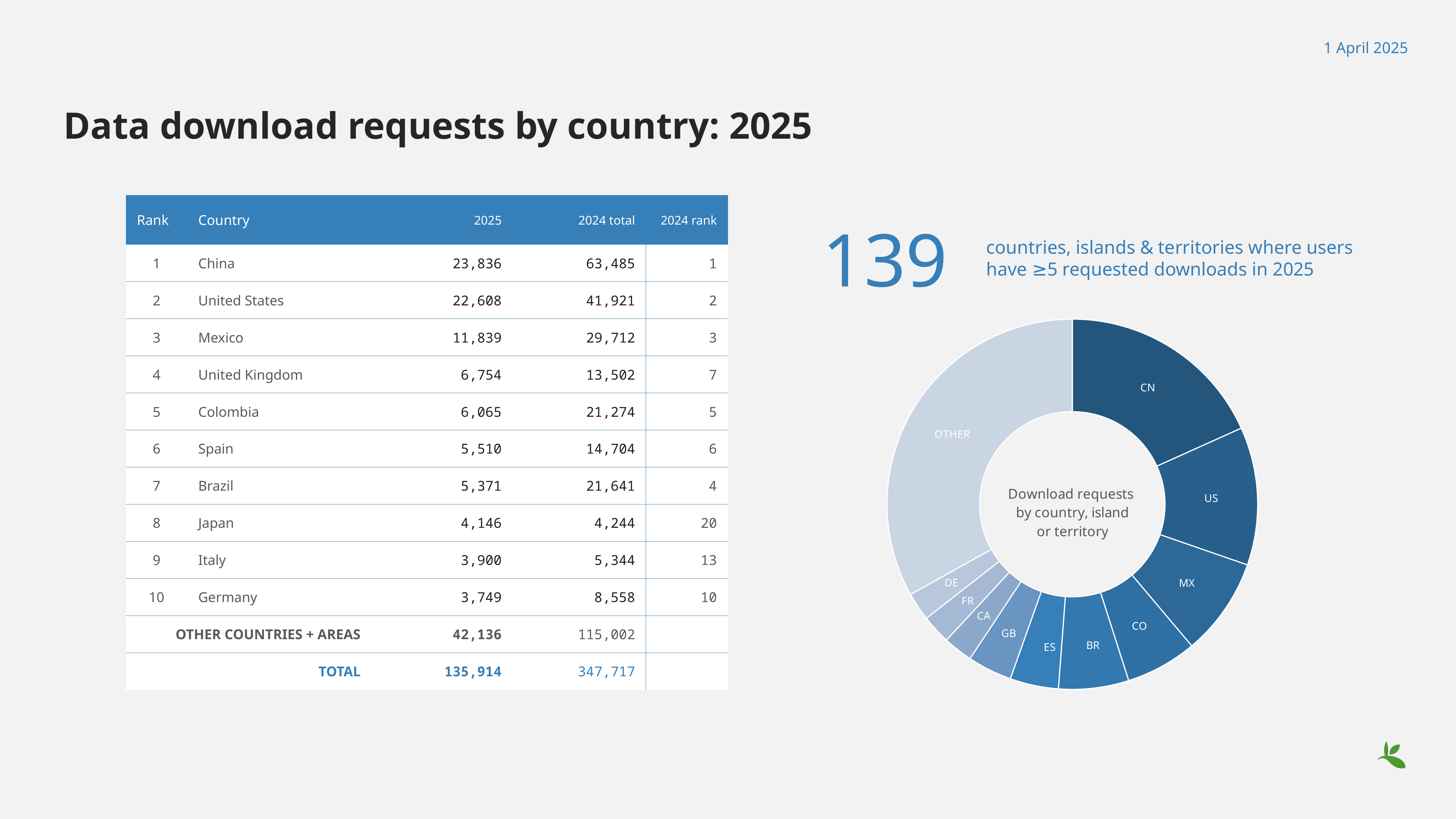
Which slice of the donut chart is the largest? OTHER According to the slide, how many download requests does the CN slice of the donut chart represent in 2025? 23,836 According to the slide, how many download requests does the OTHER slice of the donut chart represent in 2025? 42,136 In the donut chart, which slice is larger, US or GB? US Using the 2025 values on the slide, what is the difference between the CN and US slices of the donut chart? 1,228 In the donut chart, which slice is larger, MX or CO? MX How many slices does the donut chart have? 11 Which slice label appears immediately clockwise after CN in the donut chart? US What text is printed in the centre of the donut chart? Download requests by country, island or territory According to the slide, how many download requests does the MX slice of the donut chart represent in 2025? 11,839 In the donut chart, which slice is larger, OTHER or CN? OTHER What kind of chart is shown on the right of the slide? Donut (pie) chart